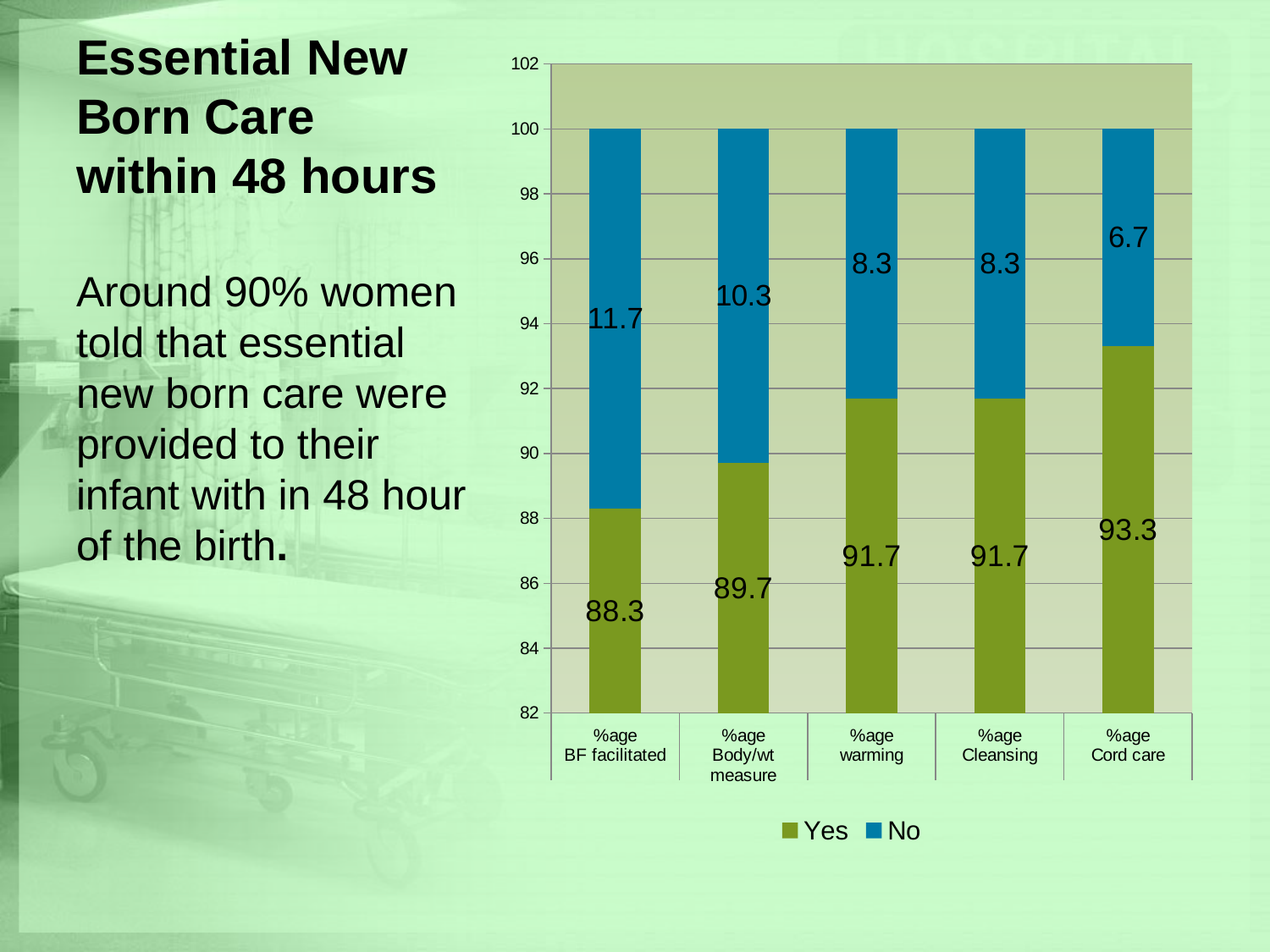
What is the 'Yes' value for %age Cord care? 93.3 How many categories are shown on the x axis? 5 Which category has the highest 'Yes' value? %age Cord care Which is larger, the 'No' value for %age BF facilitated or the 'No' value for %age Cord care? %age BF facilitated What is the 'No' value for %age Cleansing? 8.3 How many series does the legend list? 2 What is the difference between the 'Yes' values for %age Cord care and %age BF facilitated? 5 What is the 'Yes' value for %age BF facilitated? 88.3 What kind of chart is shown on the slide? Stacked bar chart What is the 'No' value for %age Body/wt measure? 10.3 Which category has the lowest 'Yes' value? %age BF facilitated What is the total of the stacked bar for %age warming? 100